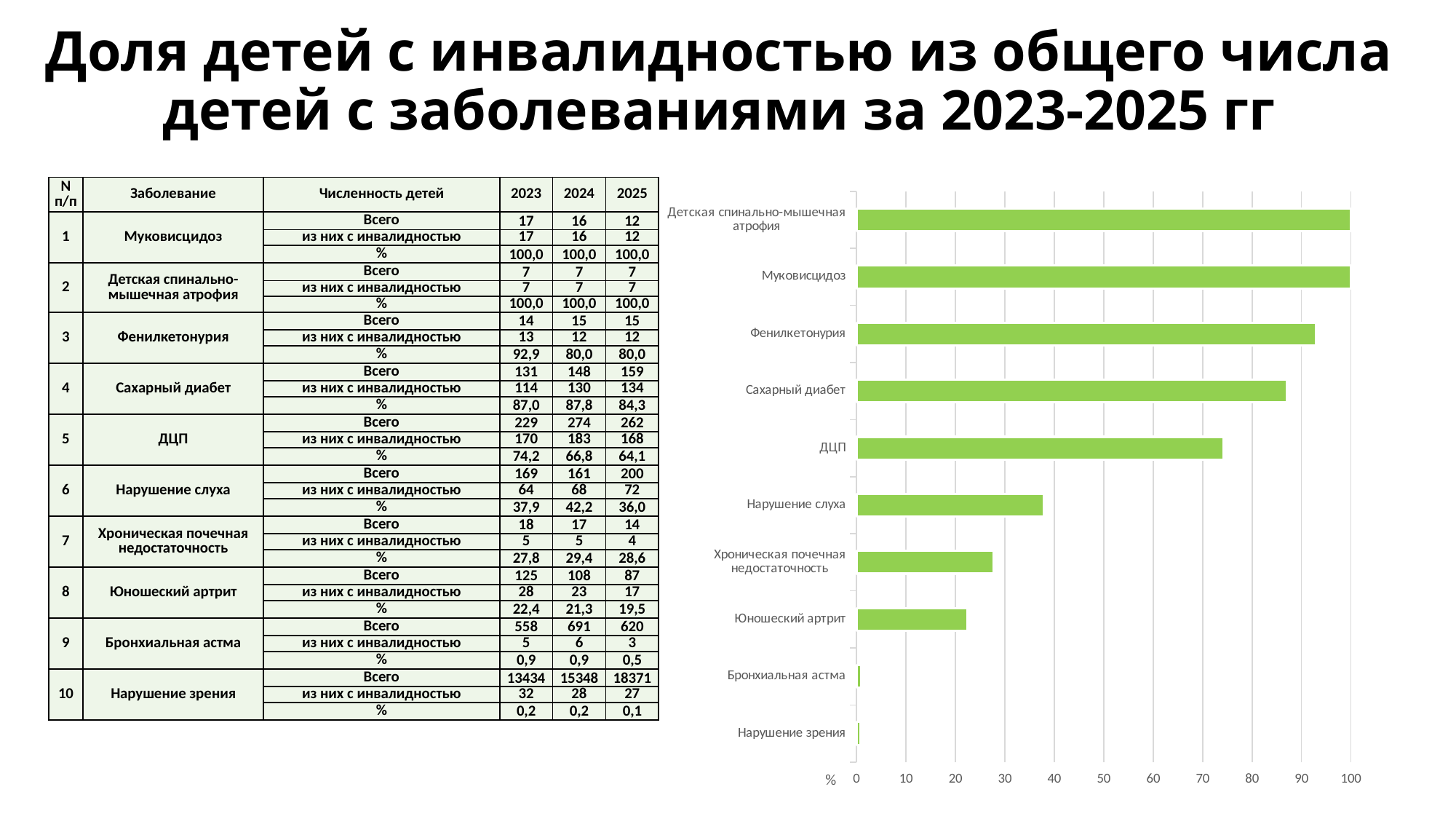
In the bar chart, which has the larger value: Нарушение слуха or Юношеский артрит? Нарушение слуха In the bar chart, is the value for Нарушение слуха greater or less than 30? greater What kind of chart is shown on the right side of the slide? bar chart How many categories (diseases) are plotted in the bar chart? 10 In the bar chart, what value does the bar for Муковисцидоз reach on the axis? 100 In the bar chart, is the value for Юношеский артрит greater or less than 30? less What unit label is shown at the bottom-left of the bar chart's horizontal axis? % In the bar chart, which has the larger value: Сахарный диабет or ДЦП? Сахарный диабет In the bar chart, is the value for Хроническая почечная недостаточность greater or less than 30? less